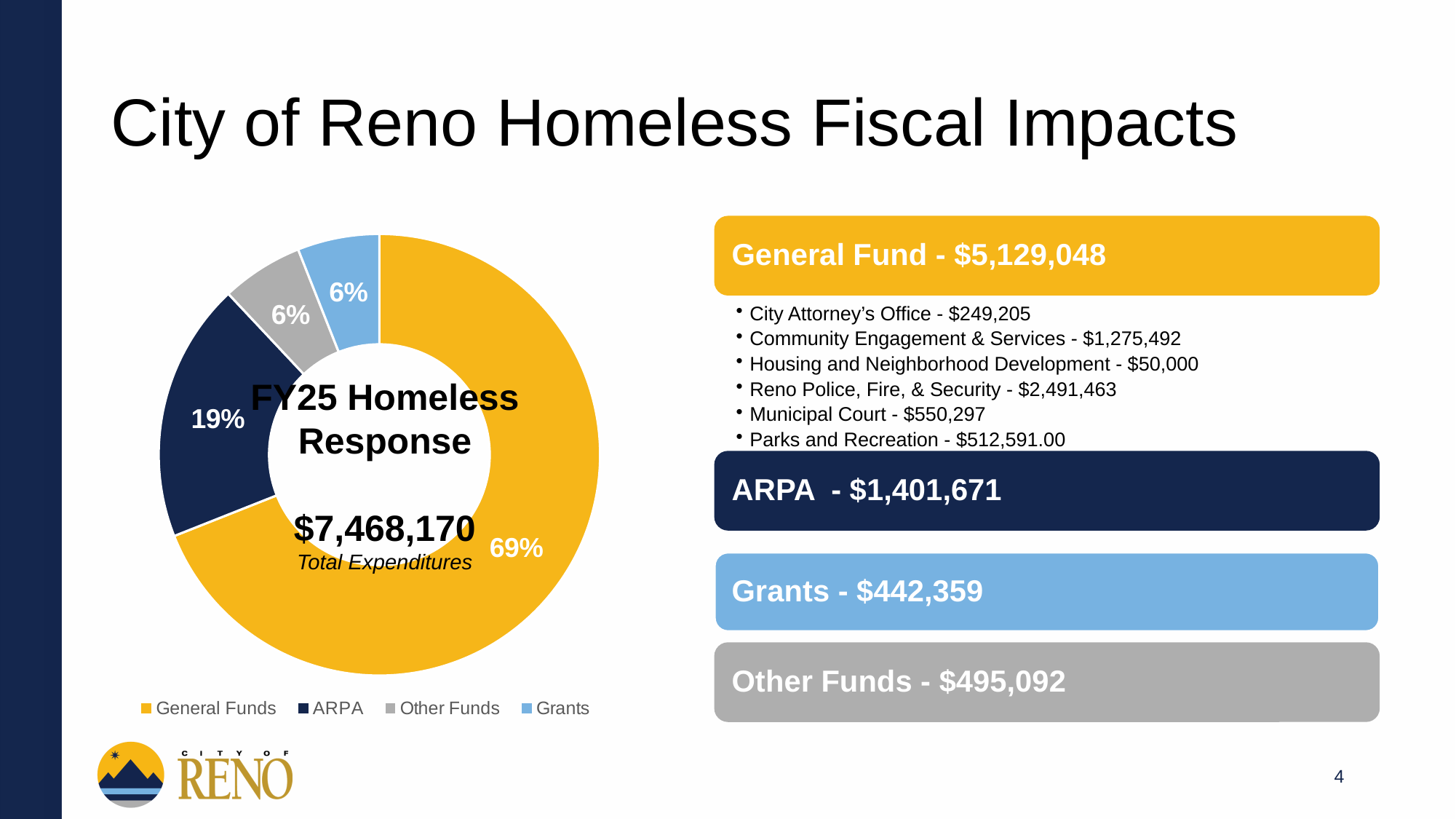
What kind of chart is shown on the slide? Doughnut (pie) chart What share of the FY25 Homeless Response doughnut chart is ARPA? 19% Which category has the largest slice in the FY25 Homeless Response chart? General Funds What colour represents ARPA in the FY25 Homeless Response chart? Dark navy blue How many entries does the legend of the FY25 Homeless Response chart list? 4 What share of the FY25 Homeless Response doughnut chart is Grants? 6% What share of the FY25 Homeless Response doughnut chart is Other Funds? 6% By how many percentage points does the General Funds share exceed the ARPA share in the FY25 Homeless Response chart? 50 percentage points How many slices does the FY25 Homeless Response doughnut chart have? 4 What total expenditures value is printed in the center of the FY25 Homeless Response chart? $7,468,170 Which slice is larger in the FY25 Homeless Response chart, ARPA or Grants? ARPA